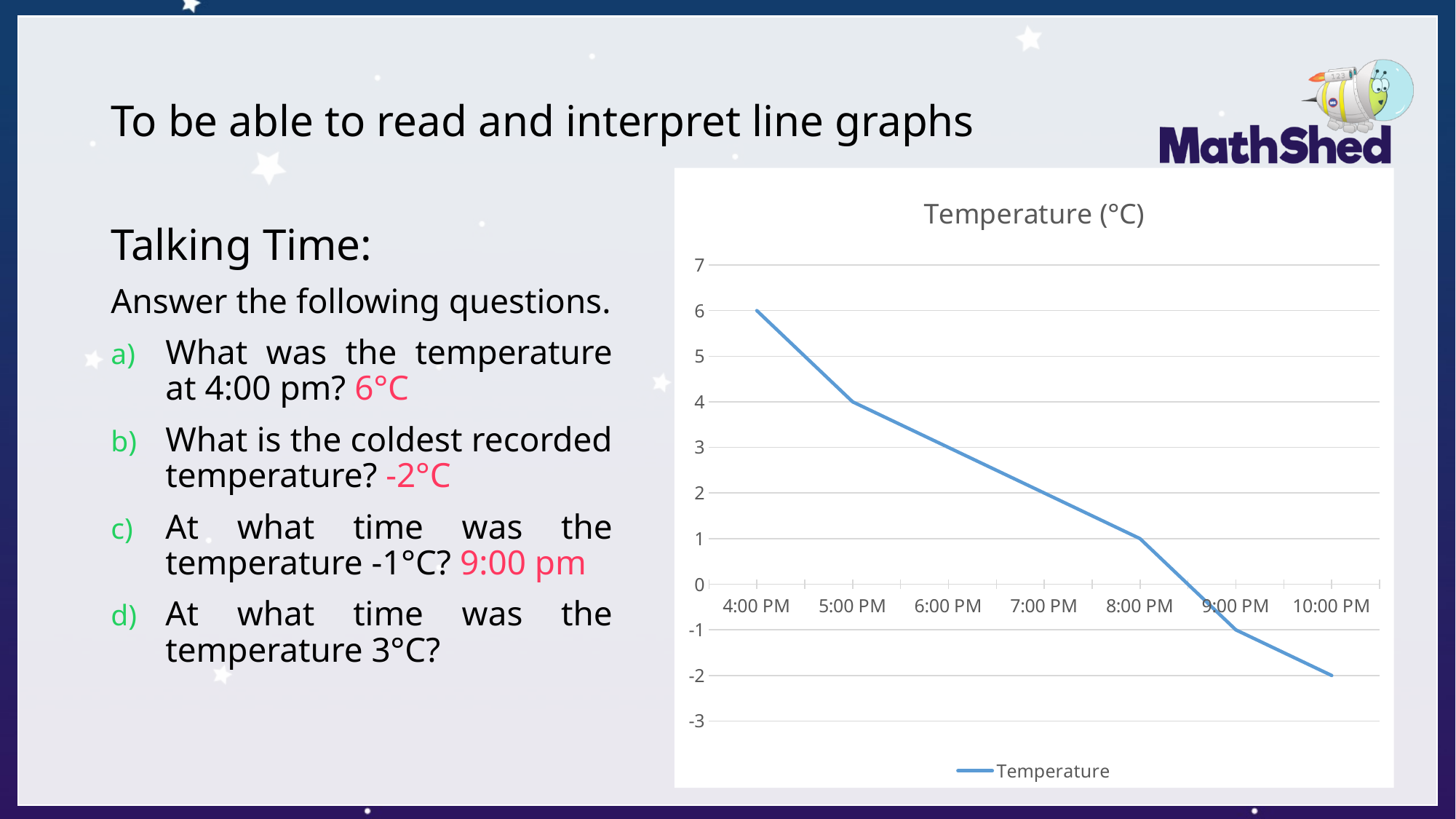
What type of chart is shown on the slide? line chart What is the title of the chart? Temperature (°C) At which time is the temperature highest? 4:00 PM How many series does the legend list? 1 What is the temperature at 5:00 PM? 4 What is the temperature at 10:00 PM? -2 What is the temperature at 4:00 PM? 6 What is the difference between the temperature at 4:00 PM and at 10:00 PM? 8 Does the temperature rise or fall from 4:00 PM to 10:00 PM? fall What is the temperature at 8:00 PM? 1 Which is higher, the temperature at 5:00 PM or at 8:00 PM? 5:00 PM At which time is the temperature lowest? 10:00 PM